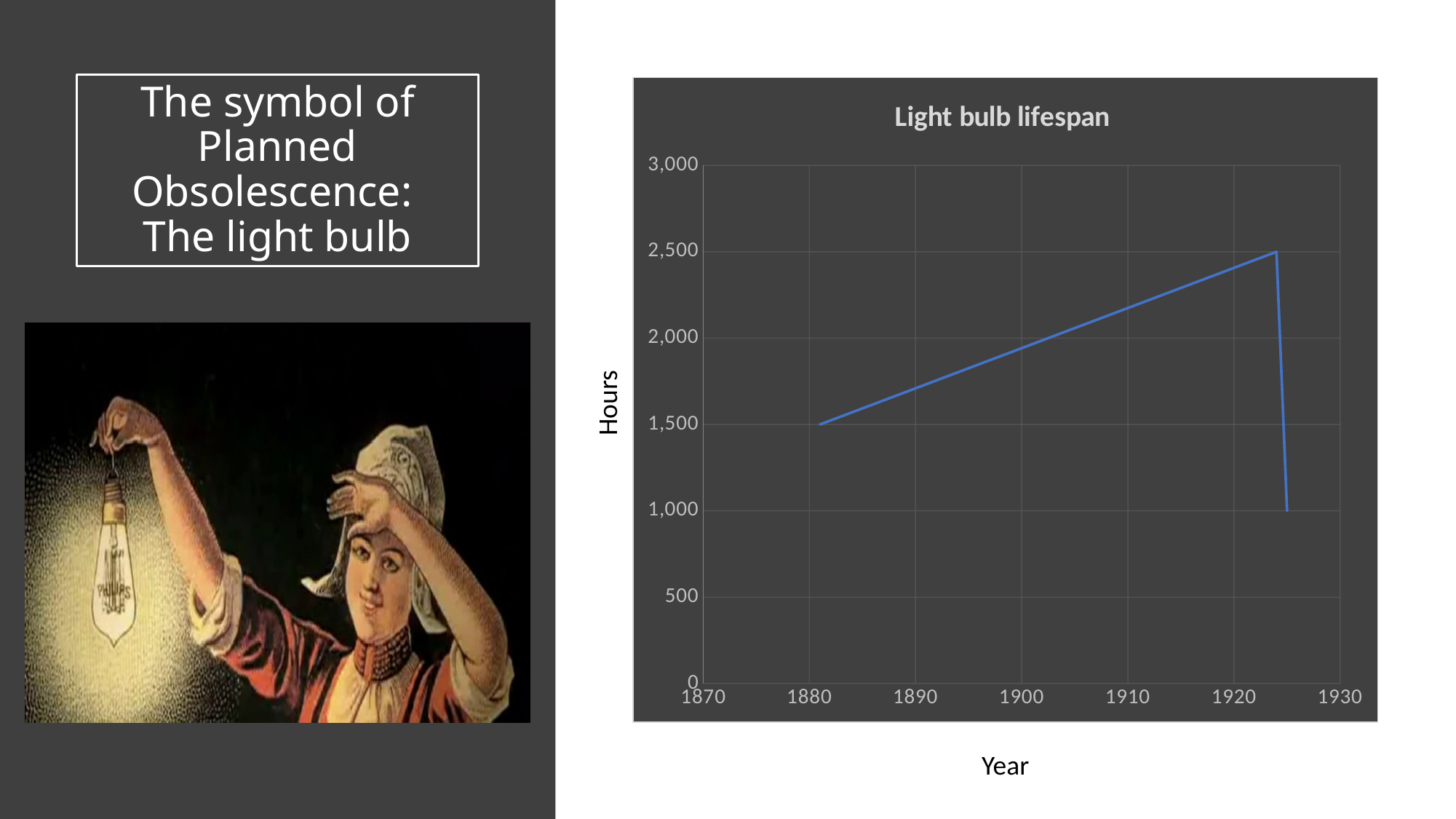
Is the value for 1910 greater or less than 2,500? less Is the highest value reached by the line greater or less than 2,000? greater Is the highest value reached by the line greater or less than 3,000? less What is the label on the vertical axis of the chart? Hours What kind of chart is shown on the slide? line chart Does the line rise or fall between 1880 and 1920? rise What is the title of the chart? Light bulb lifespan What is the highest value in hours that the line reaches? 2,500 Does the line rise or fall after its peak around 1924? fall